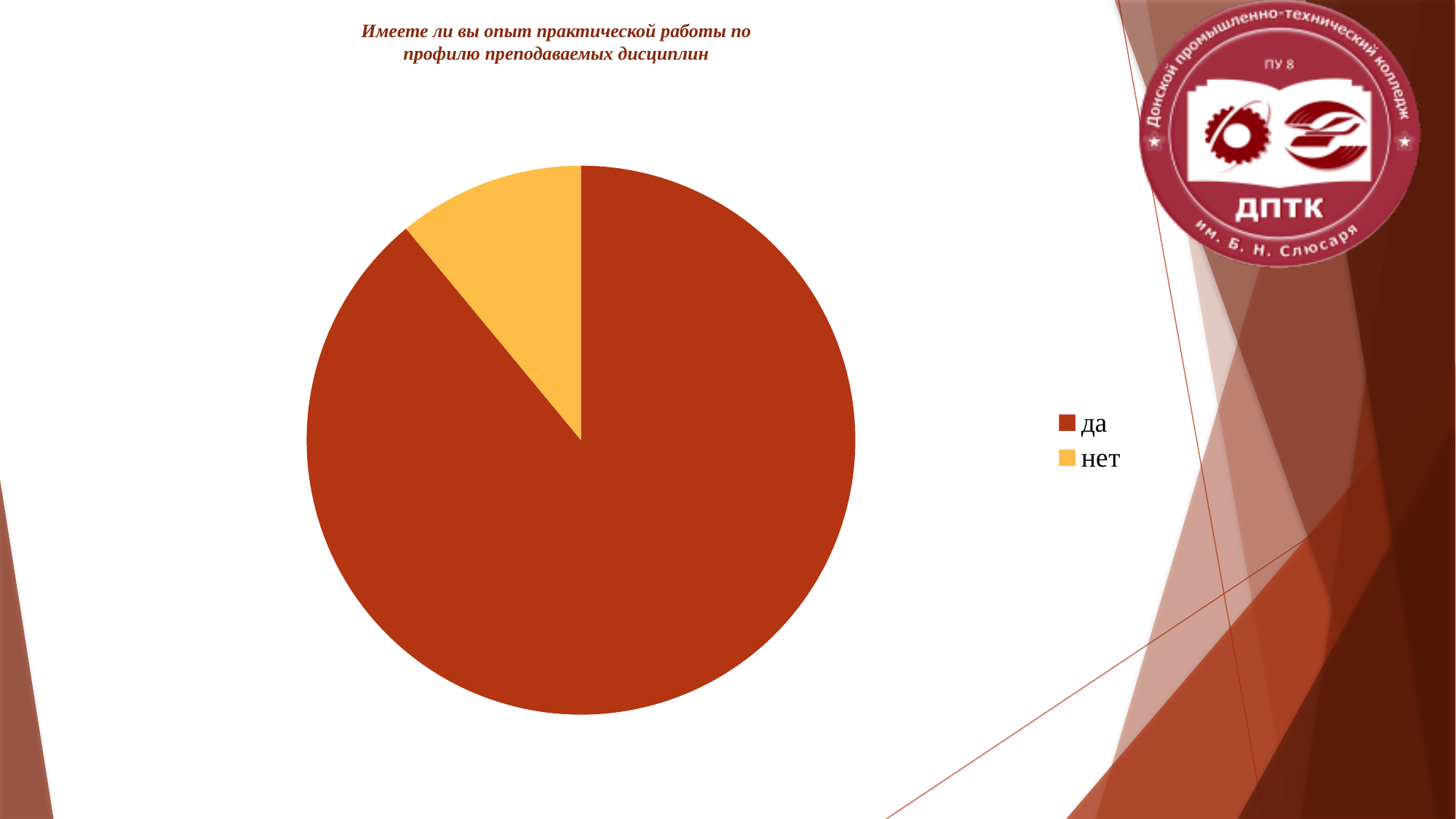
What colour is the "нет" slice in the pie chart? yellow What is the title of the pie chart? Имеете ли вы опыт практической работы по профилю преподаваемых дисциплин Which category has the largest slice in the pie chart? да Which category has the smallest slice in the pie chart? нет How many slices does the pie chart have? 2 What kind of chart is shown on the slide? pie chart Which slice is larger in the pie chart, "да" or "нет"? да How many entries does the legend of the pie chart list? 2